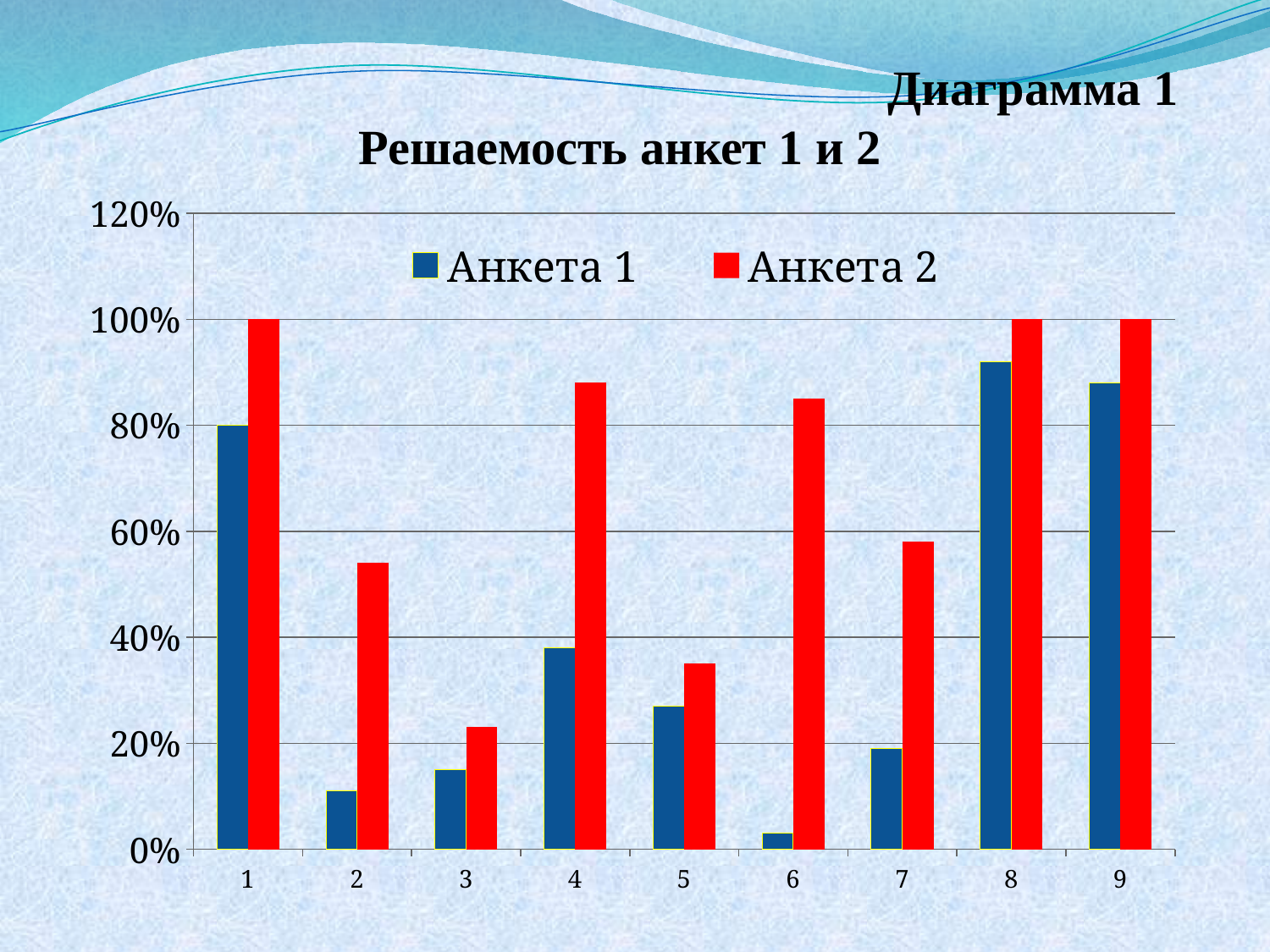
Is the value for Анкета 1 at category 6 greater or less than 20%? less Which category has the lowest value for Анкета 1? 6 How many categories are shown on the x axis? 9 What is the value for Анкета 2 at category 1? 100% How many series does the legend list? 2 What is the value for Анкета 2 at category 8? 100% What kind of chart is shown on the slide? bar chart What is the value for Анкета 1 at category 1? 80% Is the value for Анкета 2 at category 2 greater or less than 40%? greater Is the value for Анкета 2 at category 4 greater or less than 80%? greater What is the title of the chart? Решаемость анкет 1 и 2 At category 5, which series has the larger value, Анкета 1 or Анкета 2? Анкета 2